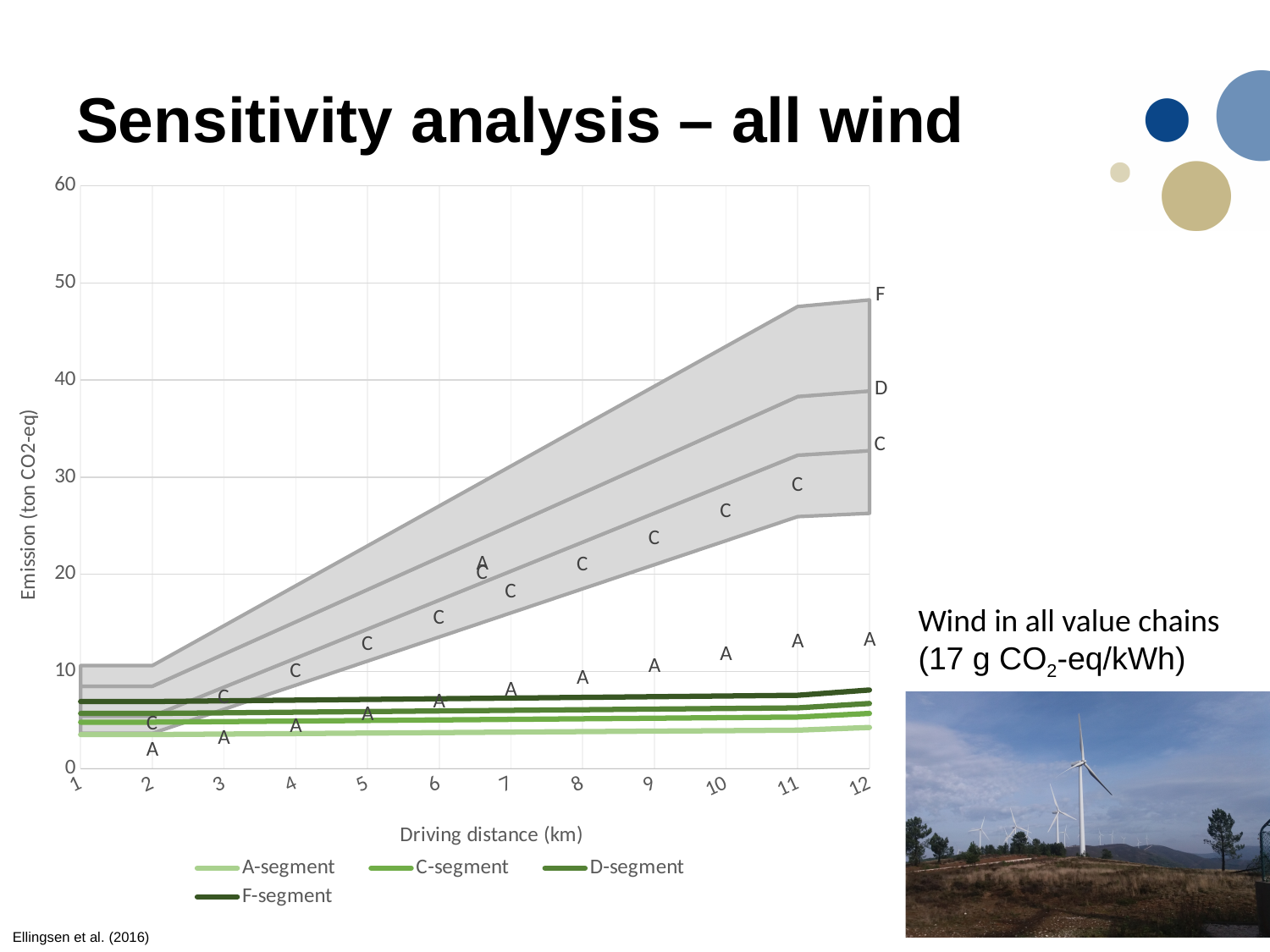
Is the value of the F-segment line at a driving distance of 12 km greater or less than 10? less Does the grey band labelled F rise or fall as driving distance increases from 2 km to 12 km? rise What is the title of the chart's x axis? Driving distance (km) Which of the four legend series has the highest line on the chart? F-segment Which of the four legend series has the lowest line on the chart? A-segment What kind of chart is shown on the slide? combination area and line chart Is the grey band line labelled C at a driving distance of 12 km greater or less than 40? less What is the title of the chart's y axis? Emission (ton CO2-eq) Is the value of the A-segment line at a driving distance of 1 km greater or less than 10? less How many series does the chart legend list? 4 How many driving-distance values are marked along the x axis? 12